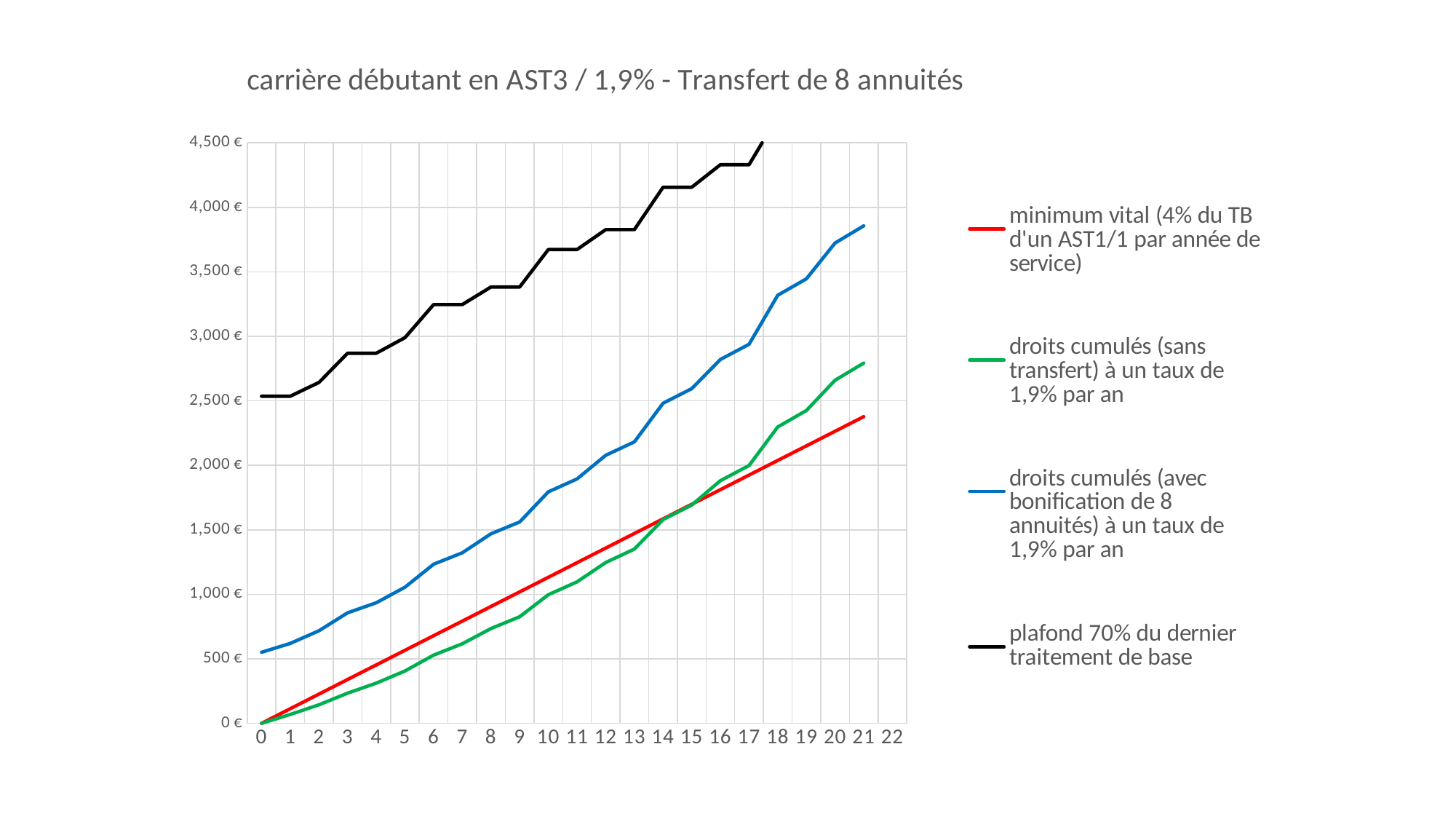
Is the value of the 'droits cumulés (avec bonification de 8 annuités)' series at year 21 greater or less than 3,500 €? greater Is the value of the 'minimum vital' series at year 21 greater or less than 2,500 €? less Do the values of the 'droits cumulés (avec bonification de 8 annuités)' series rise or fall along the x axis? rise What is the title of the chart? carrière débutant en AST3 / 1,9% - Transfert de 8 annuités What kind of chart is shown on the slide? line chart At year 21, which is higher: 'droits cumulés (avec bonification de 8 annuités)' or 'droits cumulés (sans transfert)'? droits cumulés (avec bonification de 8 annuités) à un taux de 1,9% par an Is the value of the 'droits cumulés (sans transfert)' series at year 5 greater or less than 500 €? less How many series does the legend list? 4 At year 5, which is higher: the 'minimum vital' series or the 'droits cumulés (sans transfert)' series? minimum vital (4% du TB d'un AST1/1 par année de service) Which series reaches the highest value on the chart? plafond 70% du dernier traitement de base What colour is the line for 'plafond 70% du dernier traitement de base'? black Which series has the lowest value at year 21? minimum vital (4% du TB d'un AST1/1 par année de service)